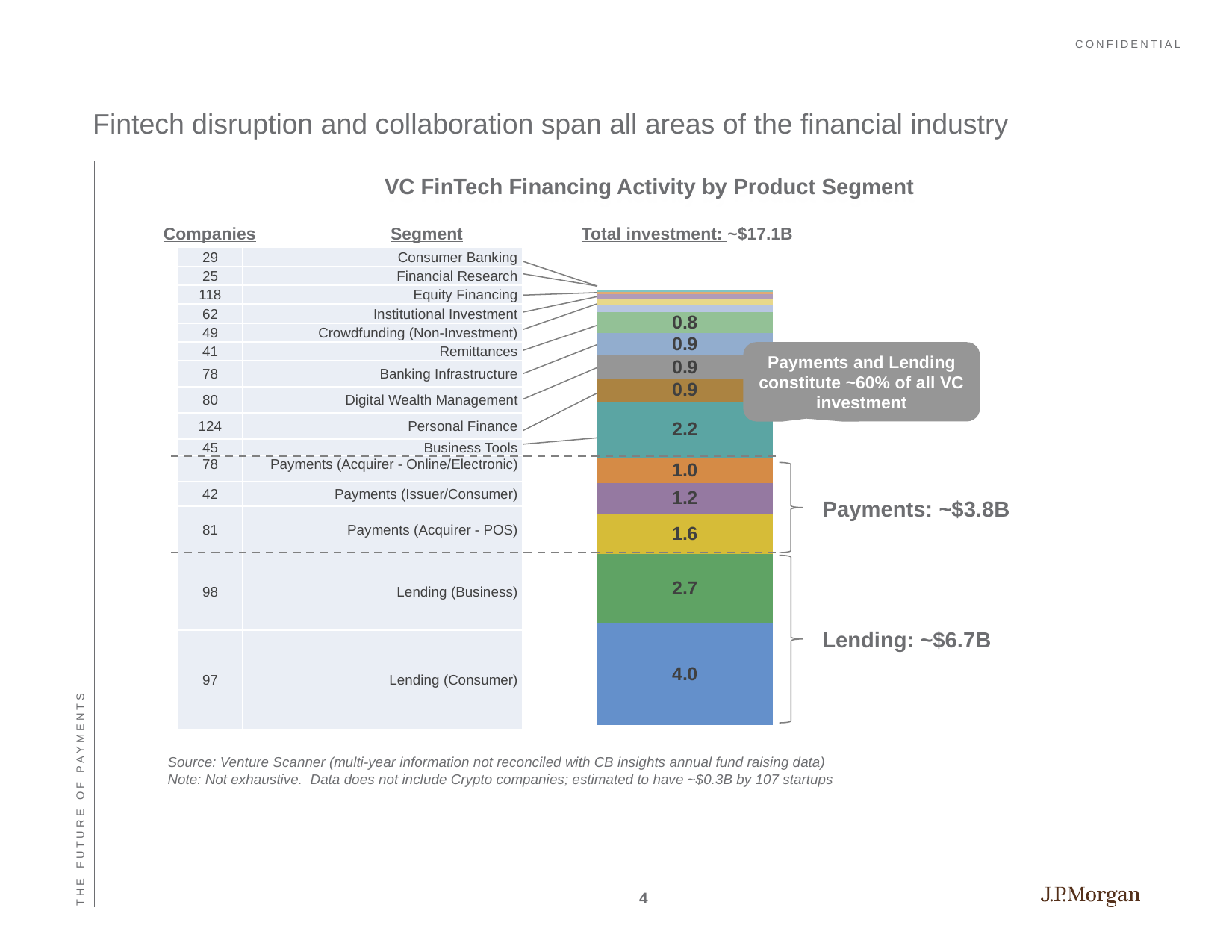
What is the value shown for the Lending (Business) segment? 2.7 What is the value shown for the Payments (Acquirer - Online/Electronic) segment? 1.0 Which is larger, the value for Payments (Acquirer - POS) or Payments (Issuer/Consumer)? Payments (Acquirer - POS) What kind of chart is shown on the slide? Stacked bar chart What is the difference between the Lending (Consumer) and Lending (Business) values? 1.3 Which segment has the largest value in the stacked bar? Lending (Consumer) What is the value shown for the Payments (Issuer/Consumer) segment? 1.2 What is the total investment shown for the Payments segments? ~$3.8B What is the title of the chart? VC FinTech Financing Activity by Product Segment What is the value shown for the Lending (Consumer) segment? 4.0 What is the total investment shown for the Lending segments? ~$6.7B What is the value shown for the Payments (Acquirer - POS) segment? 1.6